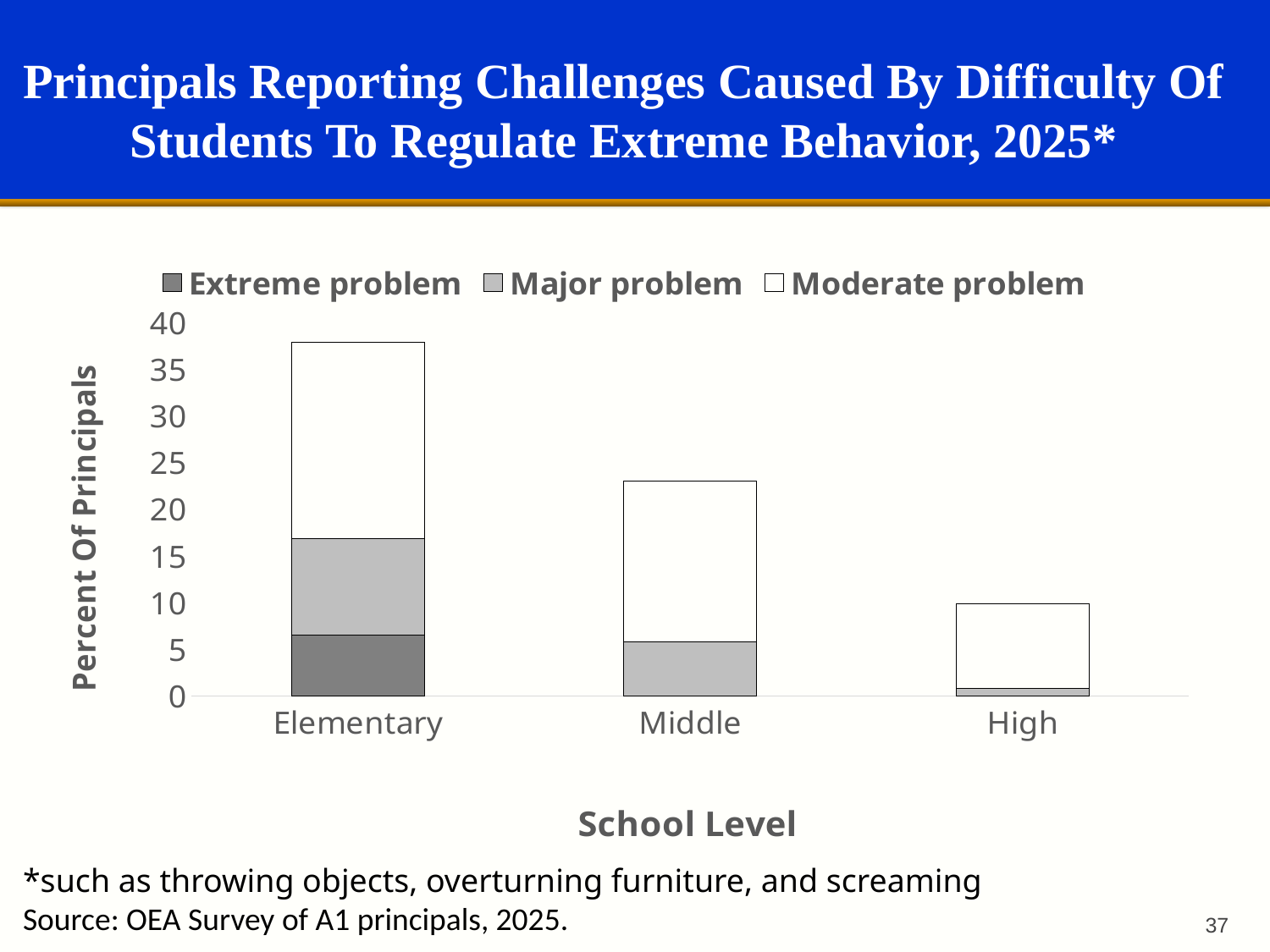
Is the total bar height for High greater or less than 15? less Which has a larger total bar, Middle or High? Middle How many school levels are shown on the x axis? 3 Is the 'Extreme problem' value for Elementary greater or less than 5? greater Which school level has the highest total percent of principals reporting a problem? Elementary Is the total bar height for Elementary greater or less than 35? greater Which school level has the lowest total percent of principals reporting a problem? High Do the total bar heights rise or fall moving from Elementary to High along the x axis? Fall What kind of chart is shown on the slide? Stacked bar chart What is the label of the y axis? Percent Of Principals How many series does the legend list? 3